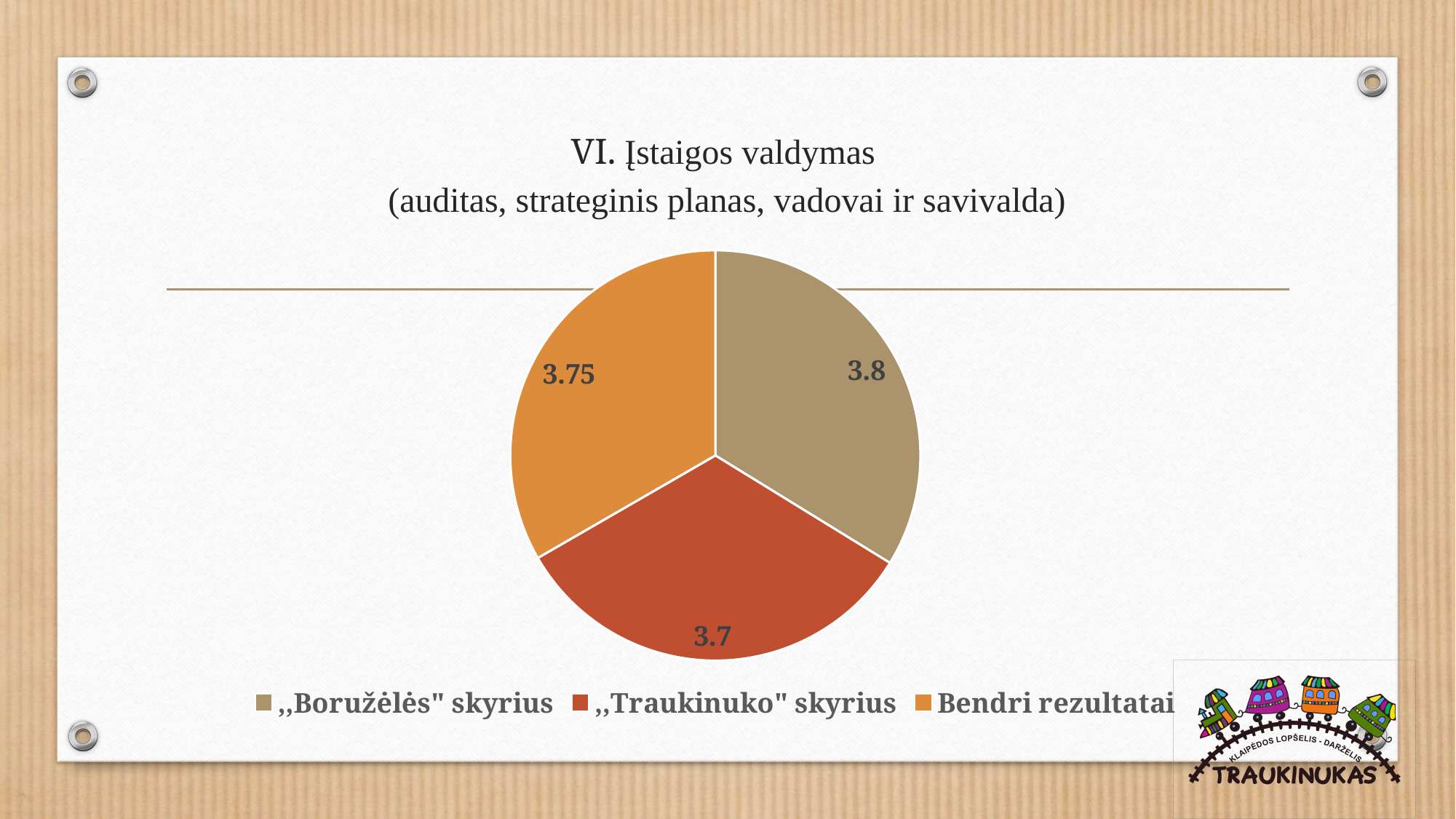
What is the value for Bendri rezultatai in the pie chart? 3.75 What is the difference between the values for "Boružėlės" skyrius and "Traukinuko" skyrius? 0.1 What is the difference between the values for "Boružėlės" skyrius and Bendri rezultatai? 0.05 Which is larger, the value for "Traukinuko" skyrius or the value for Bendri rezultatai? Bendri rezultatai Which category has the lowest value in the pie chart? "Traukinuko" skyrius What is the value for "Boružėlės" skyrius in the pie chart? 3.8 How many entries does the legend list? 3 What kind of chart is shown on the slide? Pie chart How many slices does the pie chart have? 3 What colour is the slice for Bendri rezultatai? Orange Which category has the highest value in the pie chart? "Boružėlės" skyrius What is the value for "Traukinuko" skyrius in the pie chart? 3.7